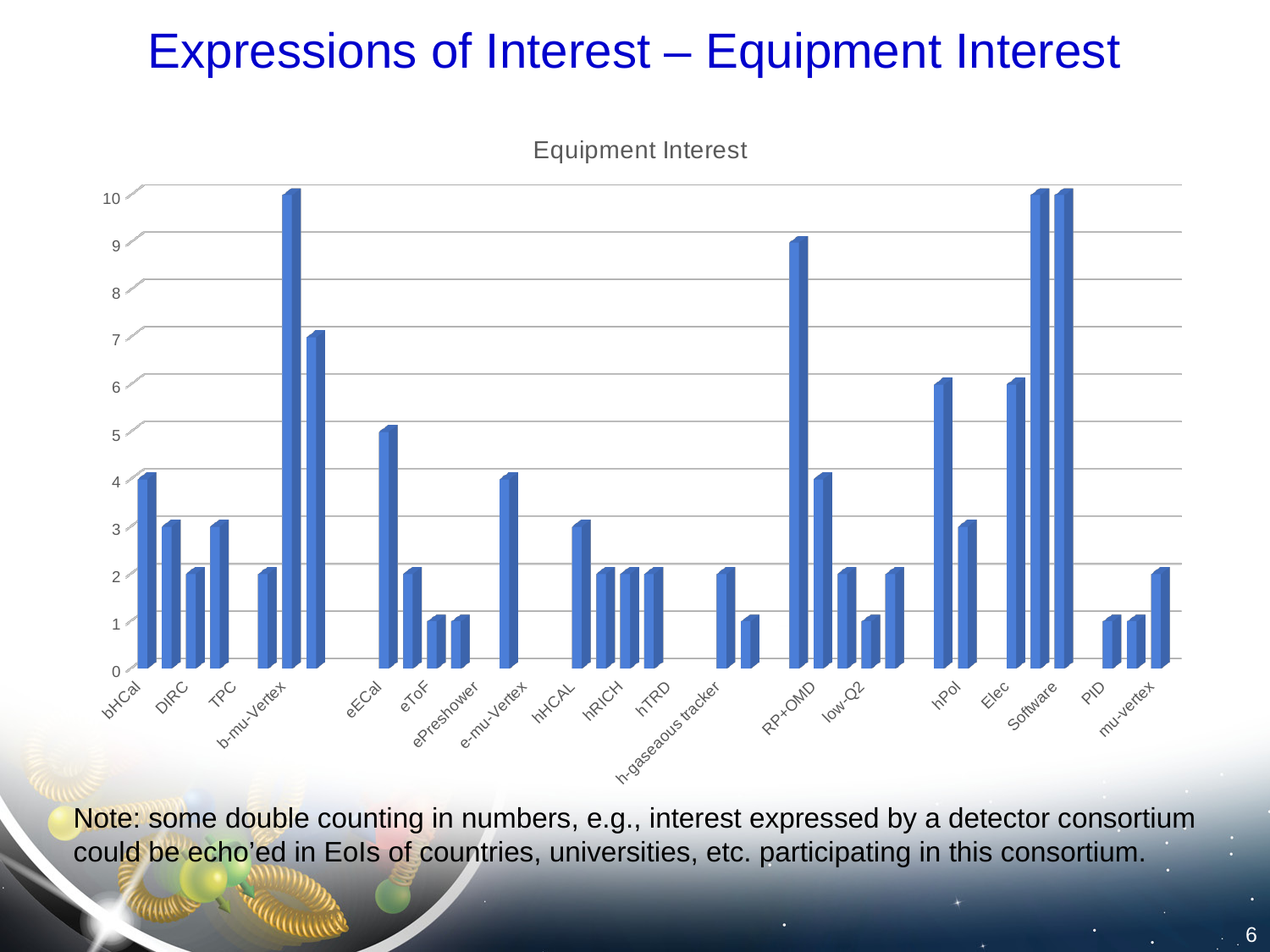
What is the maximum value shown on the vertical axis? 10 Is the value for bHCal greater or less than 5? less What is the value for bHCal? 4 Which is larger, the value for bHCal or the value for Software? Software What is the lowest non-zero value reached by any bar in the chart? 1 What is the title of the chart? Equipment Interest What is the difference between the value for Software and the value for bHCal? 6 What is the value for Software? 10 What is the highest value reached by any bar in the chart? 10 How many category labels are printed along the x axis? 19 What kind of chart is shown on the slide? bar chart How many bars reach the value 10? 3